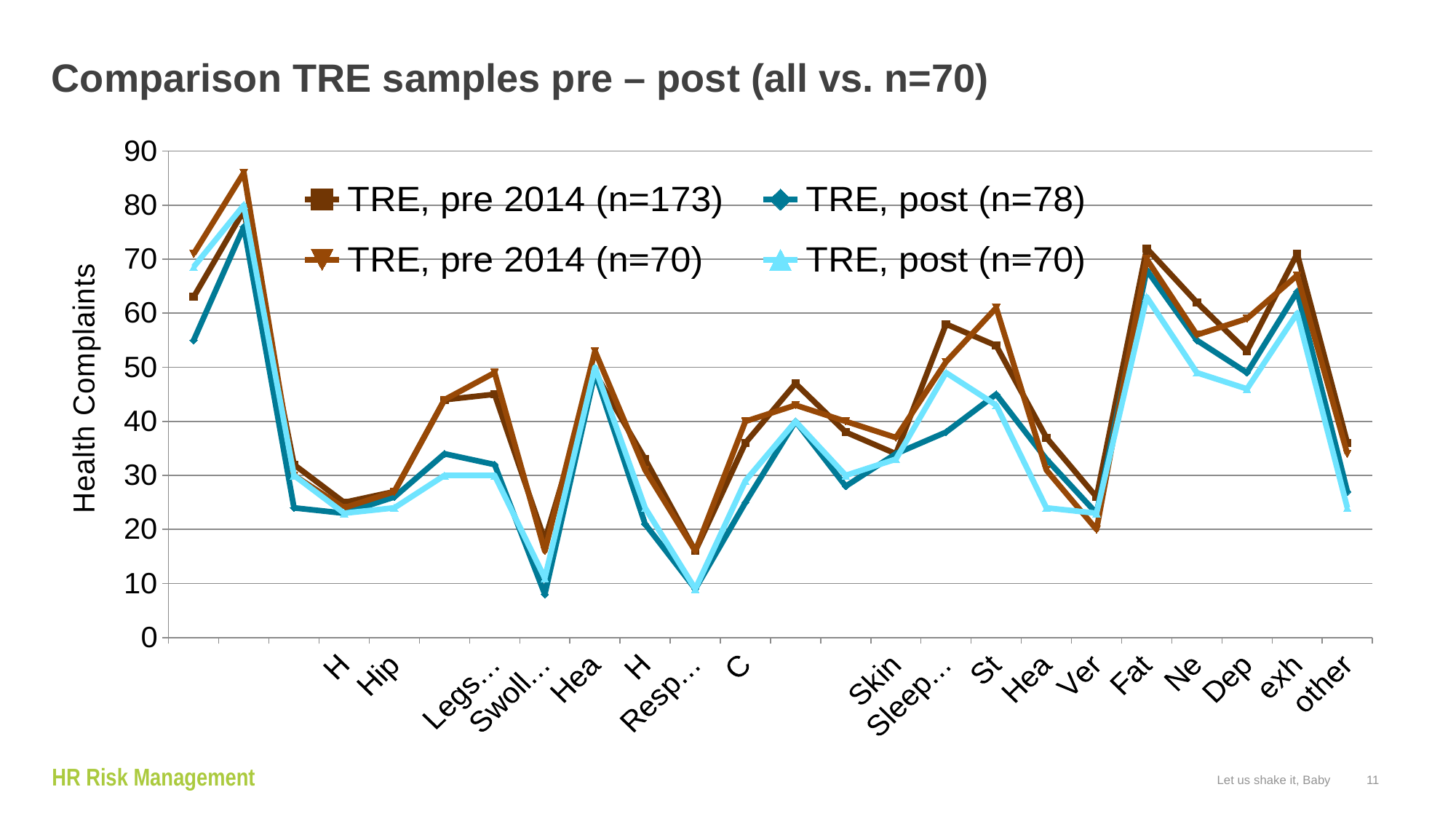
How many series does the legend list? 4 What kind of chart is shown on the slide? line chart At 'St', which series has the larger value: TRE, pre 2014 (n=70) or TRE, post (n=78)? TRE, pre 2014 (n=70) Is the value for 'Ver' in the TRE, pre 2014 (n=70) series greater or less than 30? less Is the value for 'other' in the TRE, pre 2014 (n=173) series greater or less than 30? greater At 'Dep', which series has the larger value: TRE, pre 2014 (n=70) or TRE, post (n=70)? TRE, pre 2014 (n=70) Is the value for 'Hip' in the TRE, post (n=78) series greater or less than 30? less Does the TRE, post (n=78) line rise or fall from 'Ver' to 'Fat'? rise What is the label on the vertical axis of the chart? Health Complaints Which legend entry corresponds to the sample with n=173? TRE, pre 2014 (n=173)